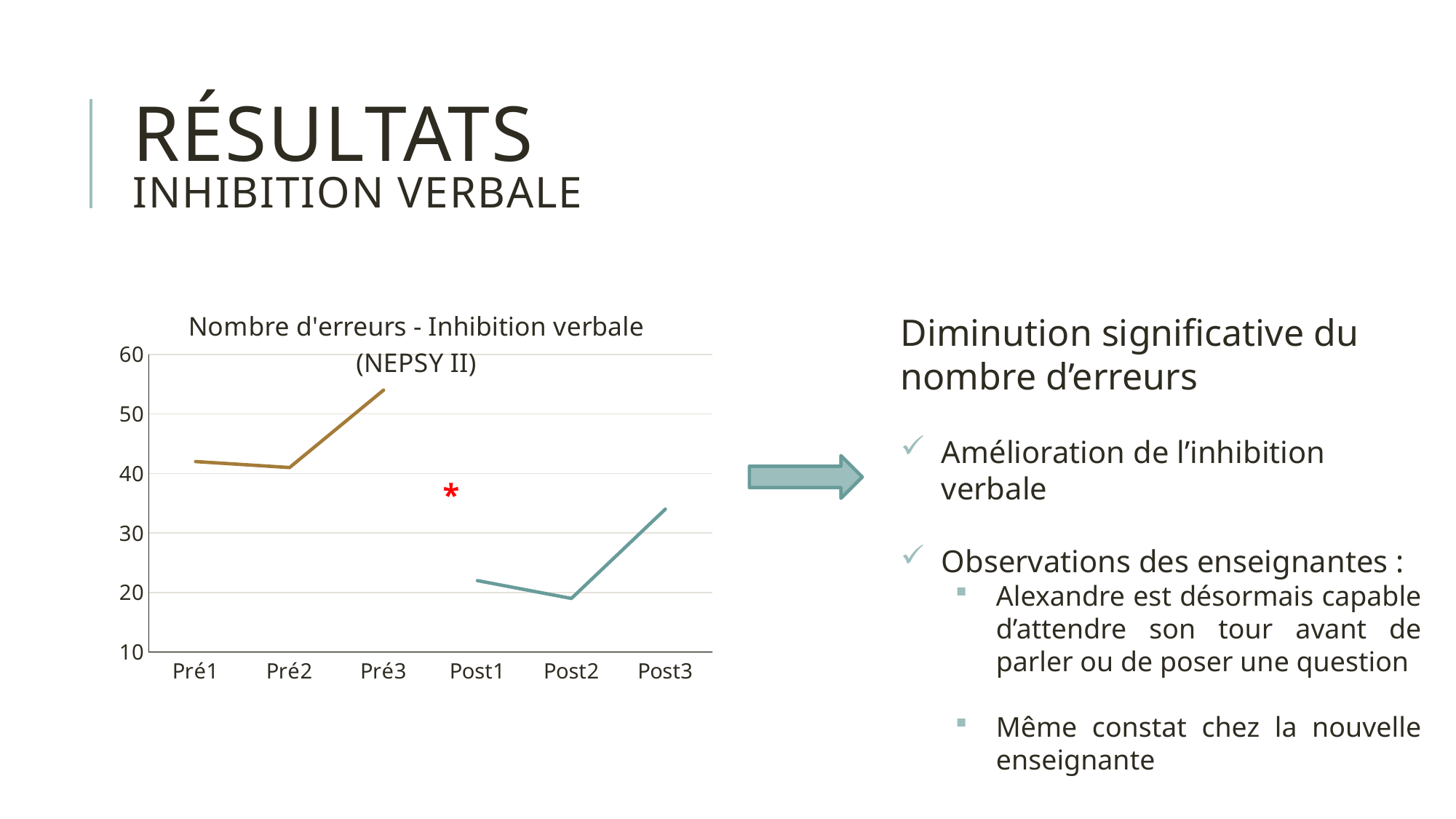
Which is larger, the value for Pré1 or the value for Post1? Pré1 Is the value for Pré1 greater or less than 30? greater Which category has the lowest number of errors? Post2 What kind of chart is shown on the slide? line chart Is the value for Pré3 greater or less than 50? greater Which is larger, the value for Post3 or the value for Pré3? Pré3 Which category has the highest number of errors? Pré3 How many categories are shown on the x axis of the chart? 6 Is the value for Post1 greater or less than 30? less What is the title of the chart? Nombre d'erreurs - Inhibition verbale (NEPSY II) Between Post2 and Post3, does the number of errors rise or fall? rise